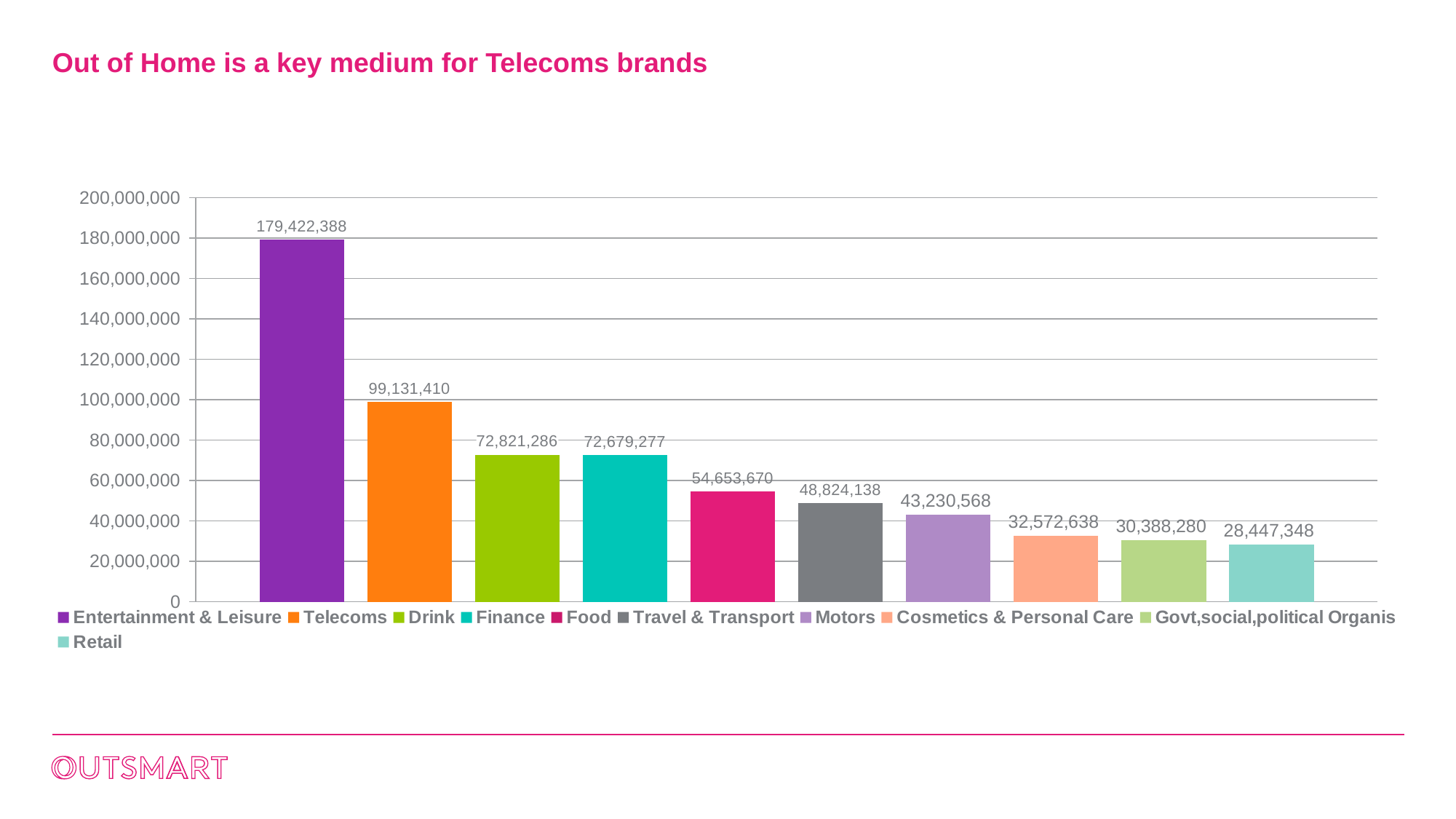
What type of chart is shown on the slide? bar chart What is the difference between the values for Food and Travel & Transport? 5,829,532 Which category has the highest value? Entertainment & Leisure How many bars are shown in the chart? 10 What is the value for Entertainment & Leisure? 179,422,388 What is the value for Retail? 28,447,348 What is the value for Telecoms? 99,131,410 Is the value for Cosmetics & Personal Care greater or less than 40,000,000? less Which is larger, the value for Telecoms or the value for Drink? Telecoms What is the difference between the values for Entertainment & Leisure and Telecoms? 80,290,978 What is the value for Motors? 43,230,568 Which category has the lowest value? Retail